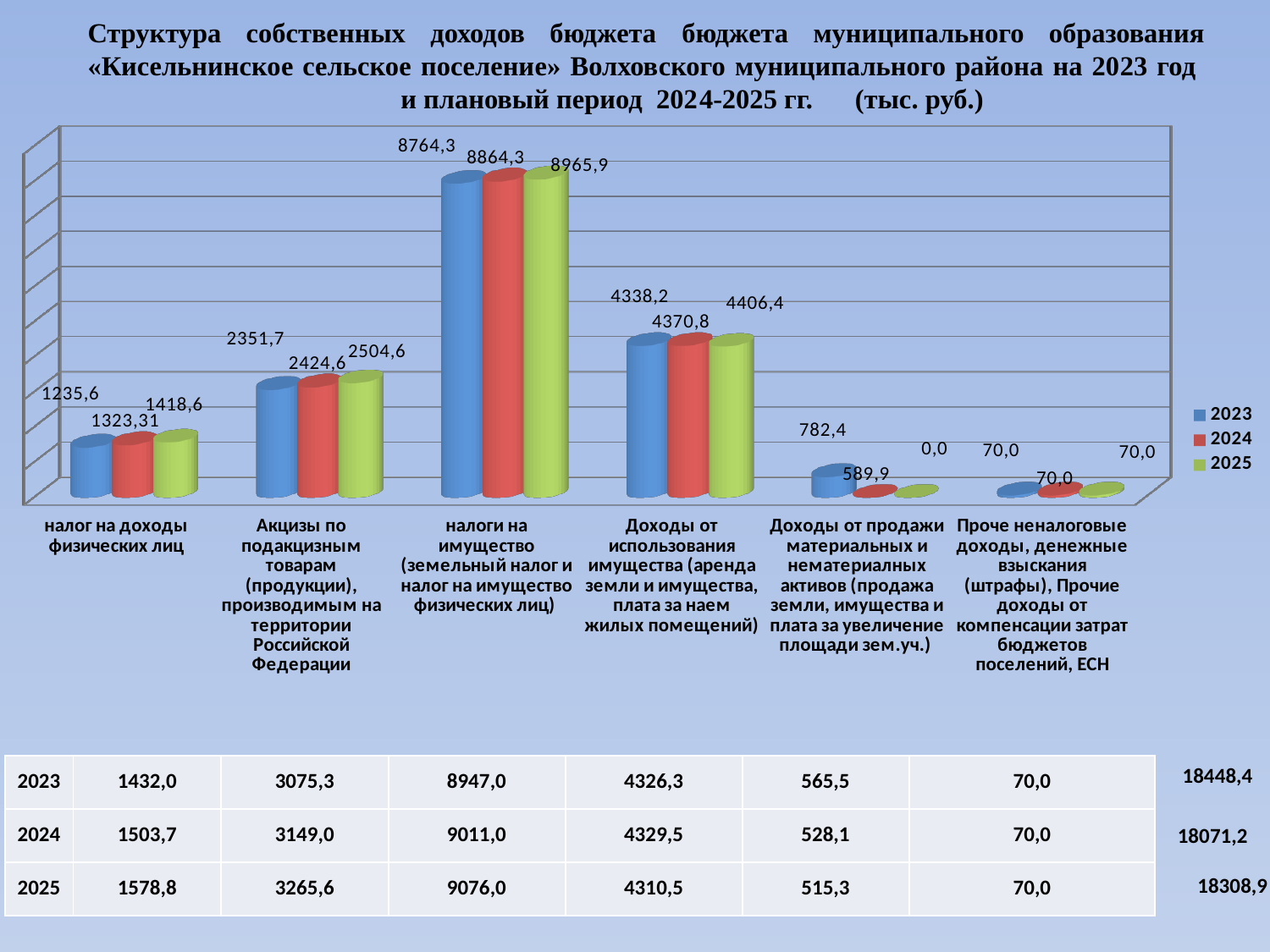
What is the 2025 value for Доходы от продажи материальных и нематериальных активов in the chart? 0,0 What is the 2024 value for Доходы от использования имущества in the chart? 4370,8 What is the 2025 value for налоги на имущество in the chart? 8965,9 Which category has the highest 2023 value in the chart? налоги на имущество How many series does the chart legend list? 3 Which is larger in the chart: the 2023 value for Доходы от продажи материальных и нематериальных активов or its 2024 value? 2023 Do the values for налоги на имущество rise or fall from 2023 to 2025 in the chart? rise What kind of chart is shown on the slide? bar chart How many categories are shown on the x axis of the chart? 6 What is the difference between the 2025 and 2023 values for Акцизы по подакцизным товарам in the chart? 152,9 What is the 2023 value for налог на доходы физических лиц in the chart? 1235,6